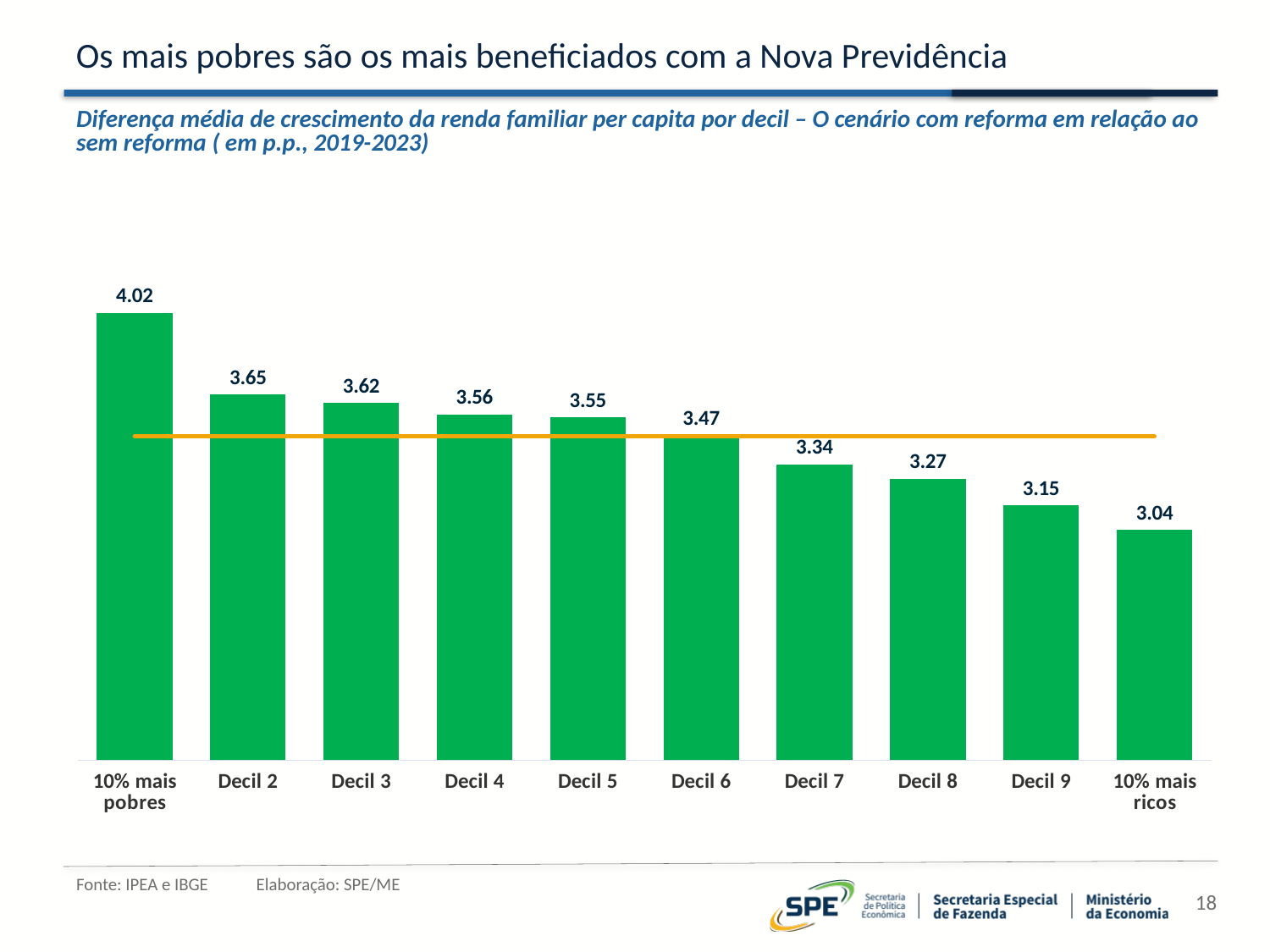
What colour are the bars in the chart? Green How many categories are shown on the x axis? 10 What is the difference between the values for Decil 2 and Decil 7? 0.31 Which category has the highest value? 10% mais pobres Which category has the lowest value? 10% mais ricos What is the value for Decil 8? 3.27 Do the values rise or fall moving from '10% mais pobres' to '10% mais ricos' along the x axis? Fall Which is larger, the value for Decil 3 or the value for Decil 9? Decil 3 What is the difference between the values for '10% mais pobres' and '10% mais ricos'? 0.98 What is the value for Decil 5? 3.55 What is the value for the '10% mais ricos' bar? 3.04 What kind of chart is shown on the slide? Bar chart